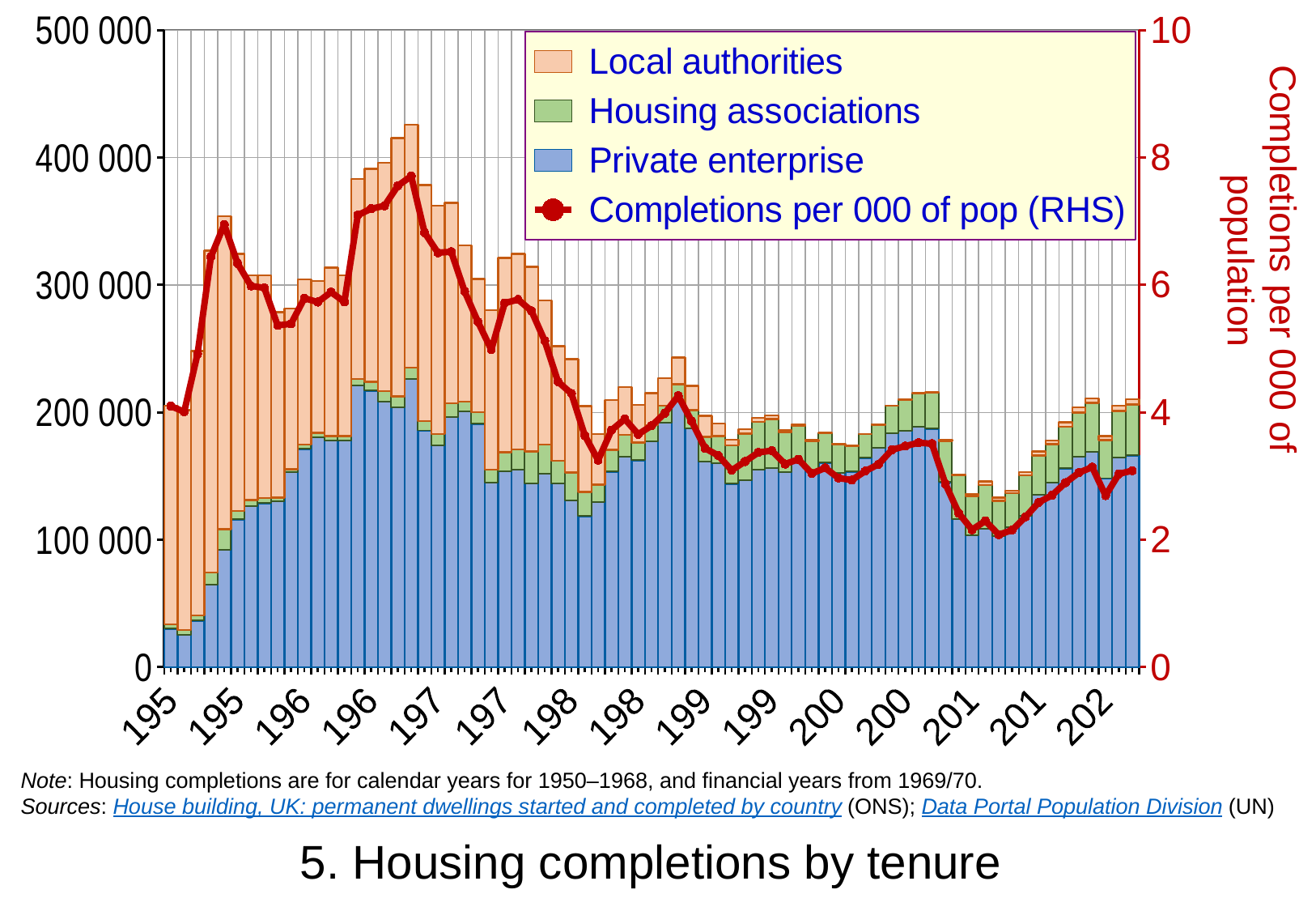
Is the rightmost value of the Completions per 000 of pop line greater or less than 4? less Is the leftmost stacked bar greater or less than 100 000? greater Is the lowest value of the Completions per 000 of pop line greater or less than 4? less What kind of chart is shown on the slide? A stacked bar chart with a line series Which series is plotted against the right-hand axis? Completions per 000 of pop (RHS) What is the title of the chart? 5. Housing completions by tenure How many series does the legend list? 4